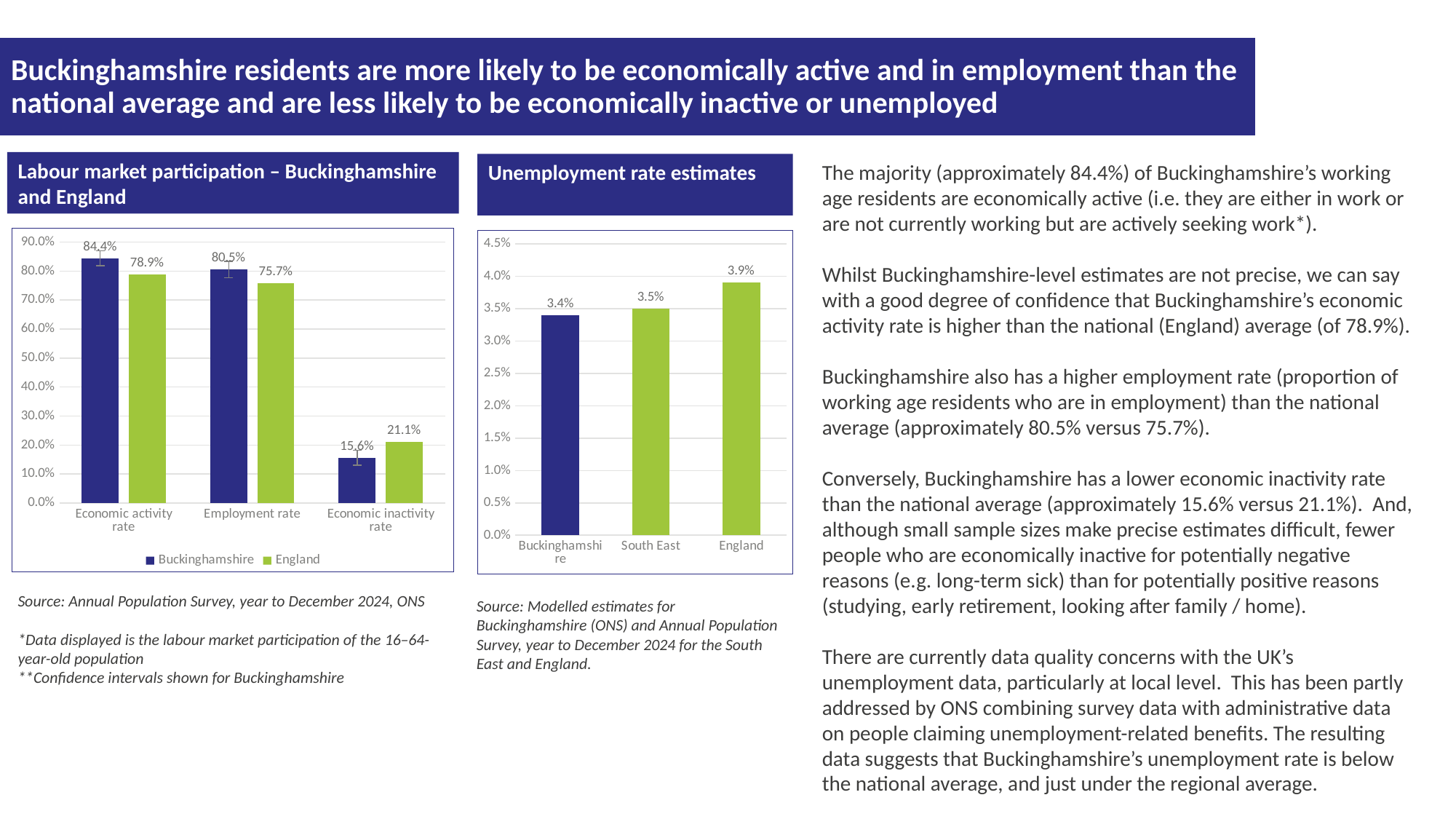
In the 'Unemployment rate estimates' chart, which area has the highest unemployment rate? England How many categories are shown on the x axis of the 'Labour market participation – Buckinghamshire and England' chart? 3 In the 'Unemployment rate estimates' chart, what is the unemployment rate for the South East? 3.5% In the 'Labour market participation – Buckinghamshire and England' chart, is the employment rate higher for Buckinghamshire or England? Buckinghamshire In the 'Labour market participation – Buckinghamshire and England' chart, what is the employment rate for England? 75.7% What type of chart is the 'Unemployment rate estimates' chart? Bar chart In the 'Labour market participation – Buckinghamshire and England' chart, what is the economic activity rate for Buckinghamshire? 84.4% In the 'Unemployment rate estimates' chart, what is the difference between the unemployment rate for England and for Buckinghamshire? 0.5% In the 'Unemployment rate estimates' chart, do the values rise or fall from left to right across the x axis? Rise How many series does the legend of the 'Labour market participation – Buckinghamshire and England' chart list? 2 In the 'Labour market participation – Buckinghamshire and England' chart, what is the difference between the economic inactivity rate for England and for Buckinghamshire? 5.5% In the 'Labour market participation – Buckinghamshire and England' chart, which category has the lowest value for Buckinghamshire? Economic inactivity rate